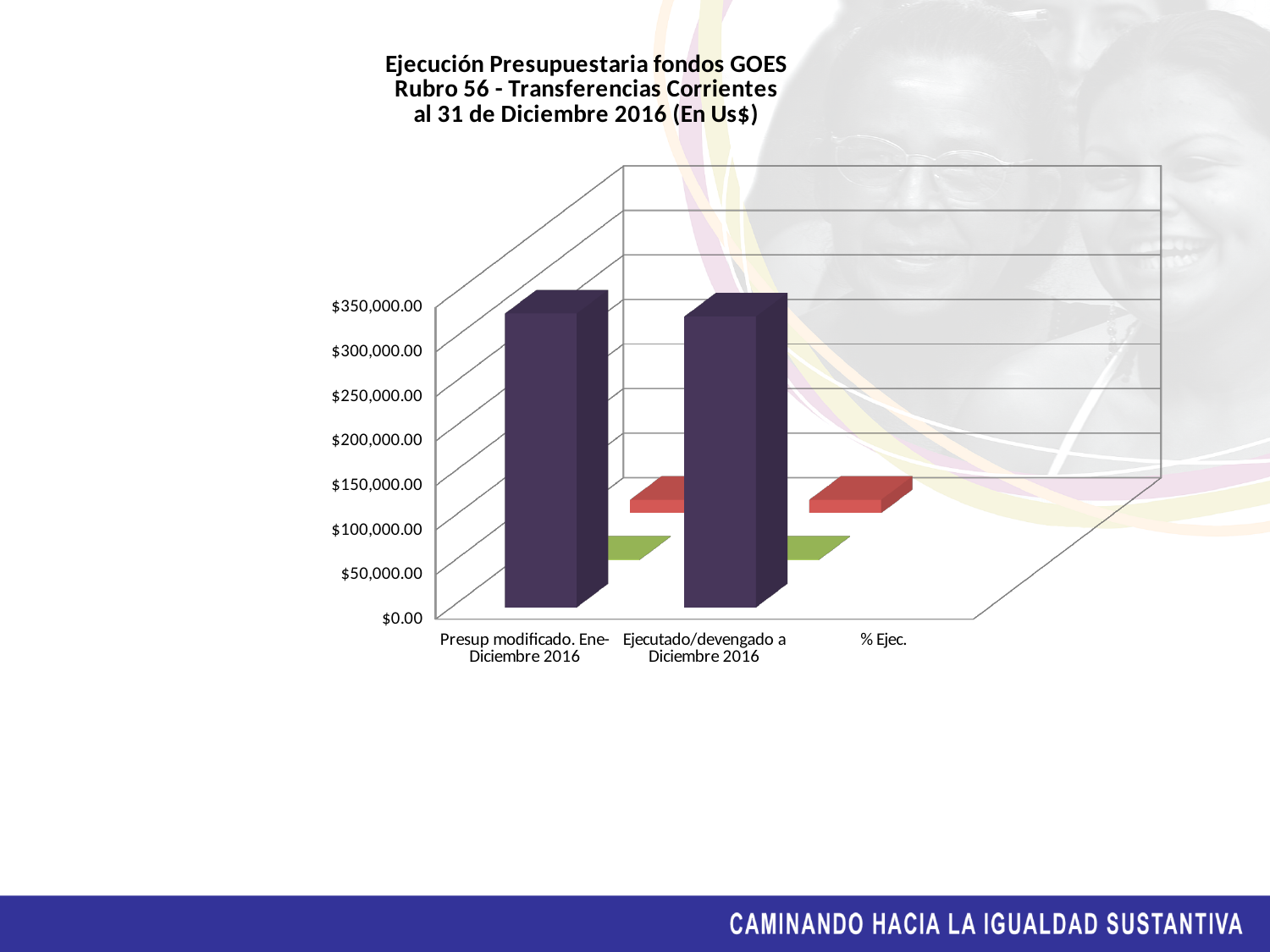
What is the highest value labelled on the vertical axis of the chart? $350,000.00 What kind of chart is shown on the slide? bar chart Which category has the lowest value in the chart? % Ejec. How many categories are shown along the x axis of the chart? 3 Is the value for "% Ejec." greater or less than $50,000.00? less Is the value for "Presup modificado. Ene-Diciembre 2016" larger or smaller than the value for "% Ejec."? larger What is the title of the chart? Ejecución Presupuestaria fondos GOES Rubro 56 - Transferencias Corrientes al 31 de Diciembre 2016 (En Us$)